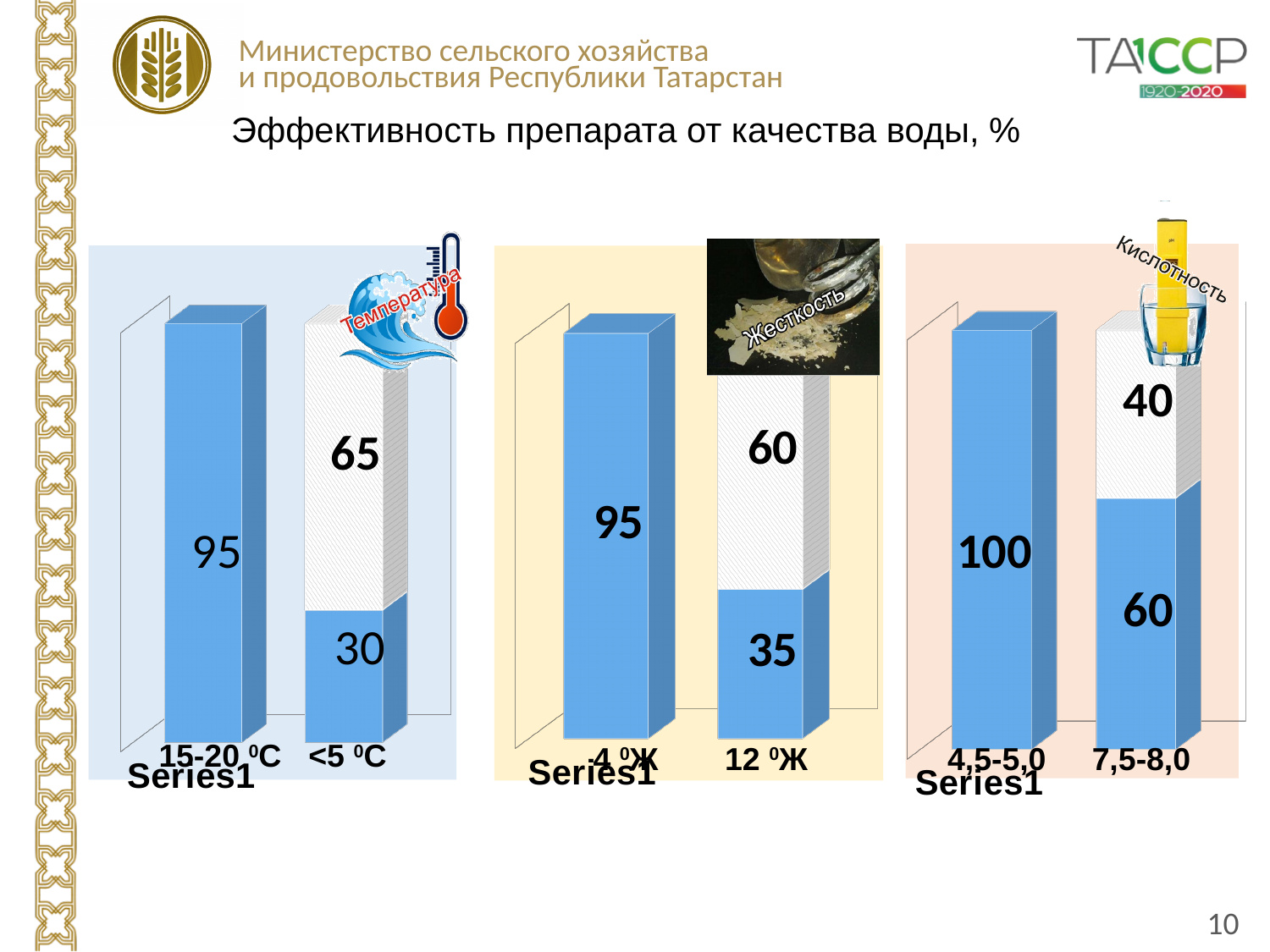
How many charts are shown on the slide? 3 In the right chart (Кислотность), what is the value of the blue bar for 4,5-5,0? 100 In the middle chart (Жесткость), which category has the larger blue value, 4 °Ж or 12 °Ж? 4 °Ж In the left chart (Температура), what is the value of the blue bar for 15-20 °C? 95 In the left chart (Температура), what is the difference between the blue values for 15-20 °C and <5 °C? 65 In the right chart (Кислотность), what is the value of the white segment for 7,5-8,0? 40 In the left chart (Температура), what is the value of the blue segment for <5 °C? 30 What type of chart is used in the left chart (Температура)? Bar chart In the middle chart (Жесткость), what is the value of the blue segment for 12 °Ж? 35 What is the title of the slide above the charts? Эффективность препарата от качества воды, % In the right chart (Кислотность), what is the total of the stacked bar for 7,5-8,0 (blue plus white)? 100 In the middle chart (Жесткость), what is the total of the stacked bar for 12 °Ж (blue plus white)? 95